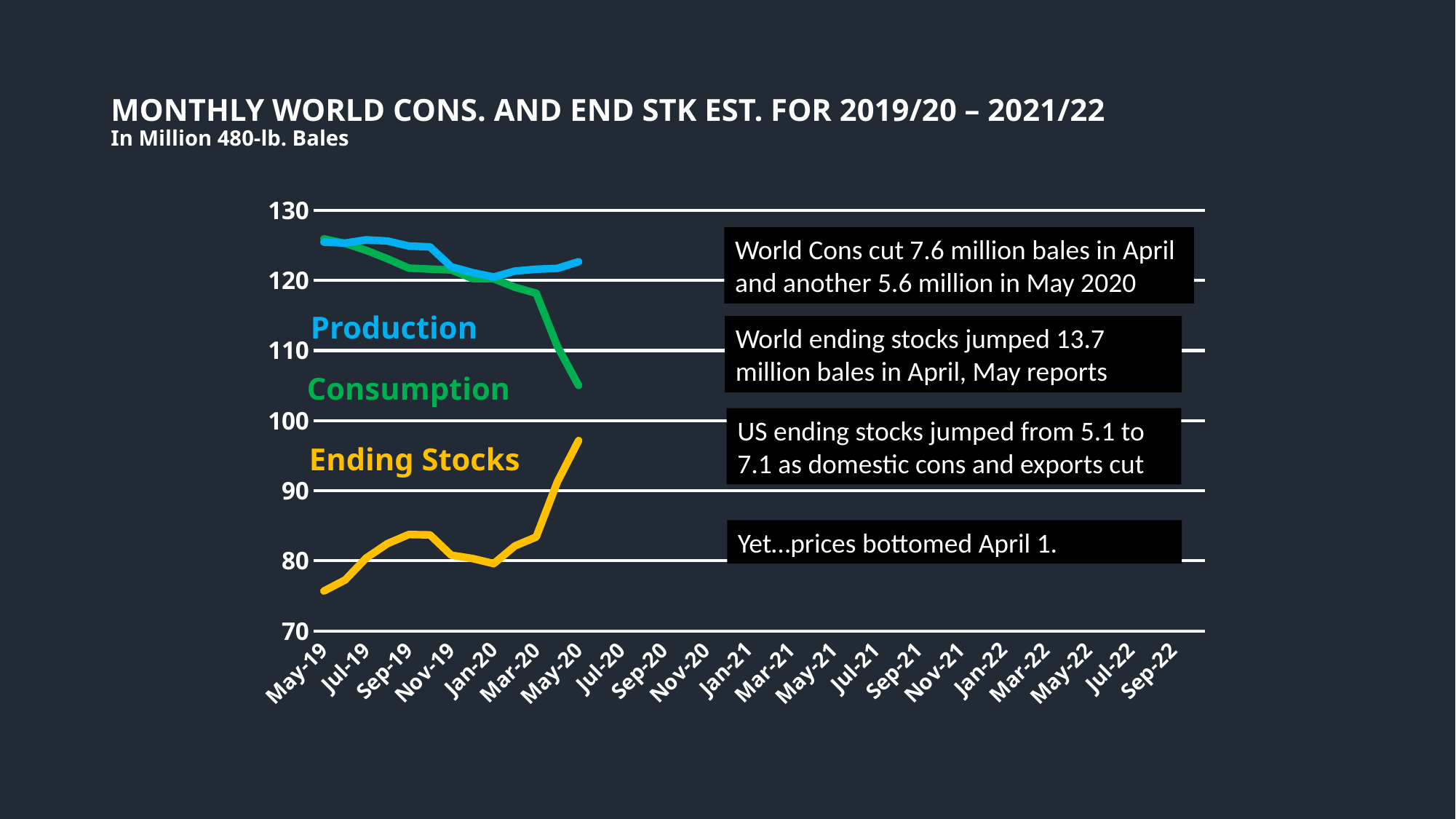
Does the Ending Stocks line rise or fall between Mar-20 and May-20? Rise Which series has the lowest values throughout the plotted period? Ending Stocks Is the Consumption value at May-20 greater or less than 110? less What kind of chart is shown on the slide? Line chart Is the Ending Stocks value at May-19 greater or less than 80? less Does the Consumption line rise or fall between Jan-20 and May-20? Fall Is the Ending Stocks value at May-20 greater or less than 90? greater At May-20, which is higher, Production or Consumption? Production How many series are plotted on the chart? 3 How many month labels are shown on the x axis? 21 What unit does the chart subtitle say the values are in? In Million 480-lb. Bales What are the names of the three series plotted on the chart? Production, Consumption, Ending Stocks